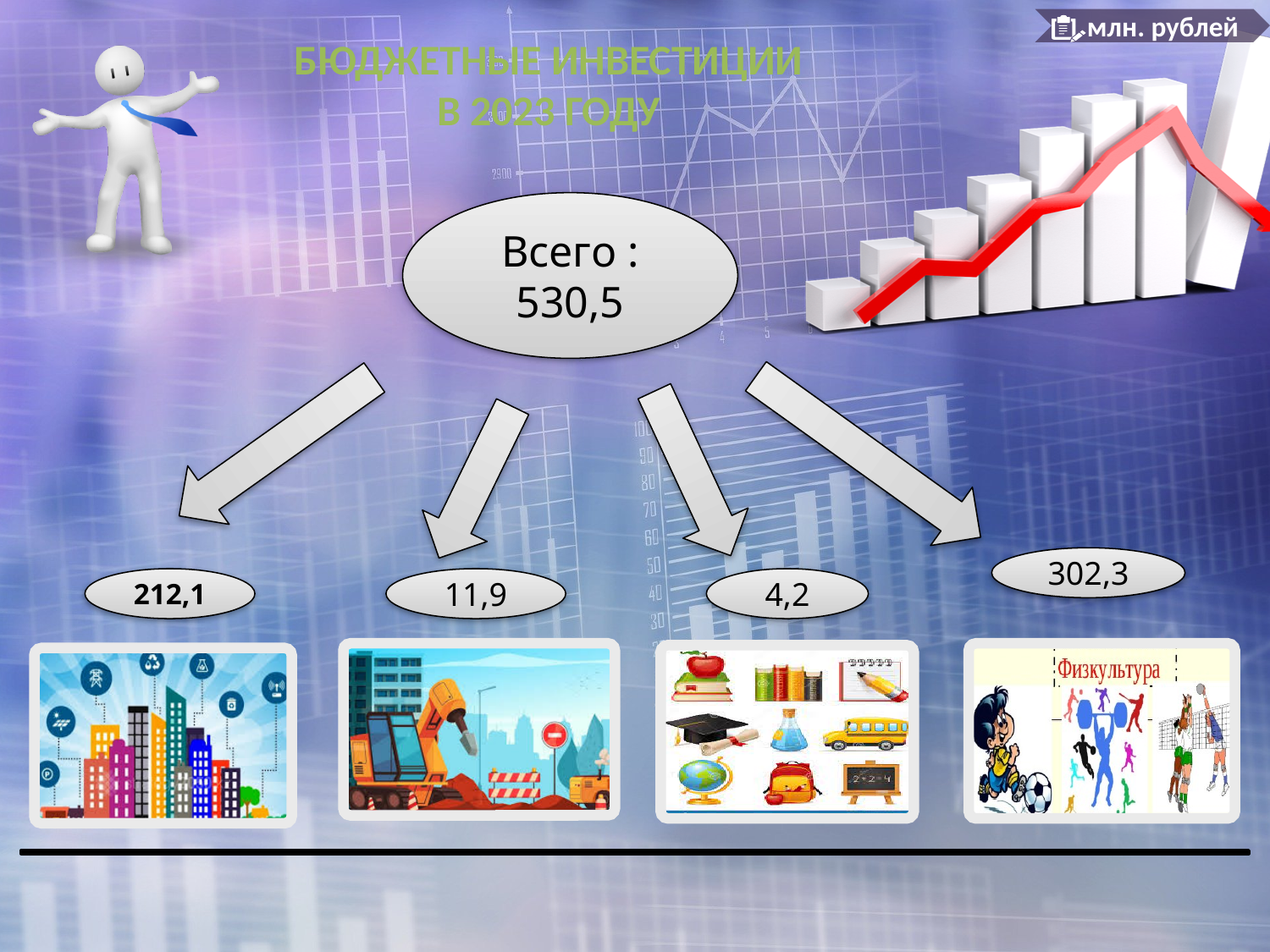
Which of the four branch values in the diagram is the smallest? 4,2 What is the total value shown in the central oval of the diagram ("Всего")? 530,5 What is the title of the diagram on the slide? БЮДЖЕТНЫЕ ИНВЕСТИЦИИ В 2023 ГОДУ What is the difference between the rightmost value (302,3) and the leftmost value (212,1)? 90,2 What unit is indicated in the top-right corner of the slide? млн. рублей What is the value shown in the rightmost oval above the "Физкультура" picture? 302,3 Which of the four branch values in the diagram is the largest? 302,3 How many branch values are shown below the total in the diagram? 4 Which is larger: the leftmost value (212,1) or the rightmost value (302,3)? 302,3 What is the value shown in the oval above the construction picture (second from left)? 11,9 What is the value shown in the leftmost oval above the city picture? 212,1 What is the value shown in the oval above the school supplies picture (third from left)? 4,2